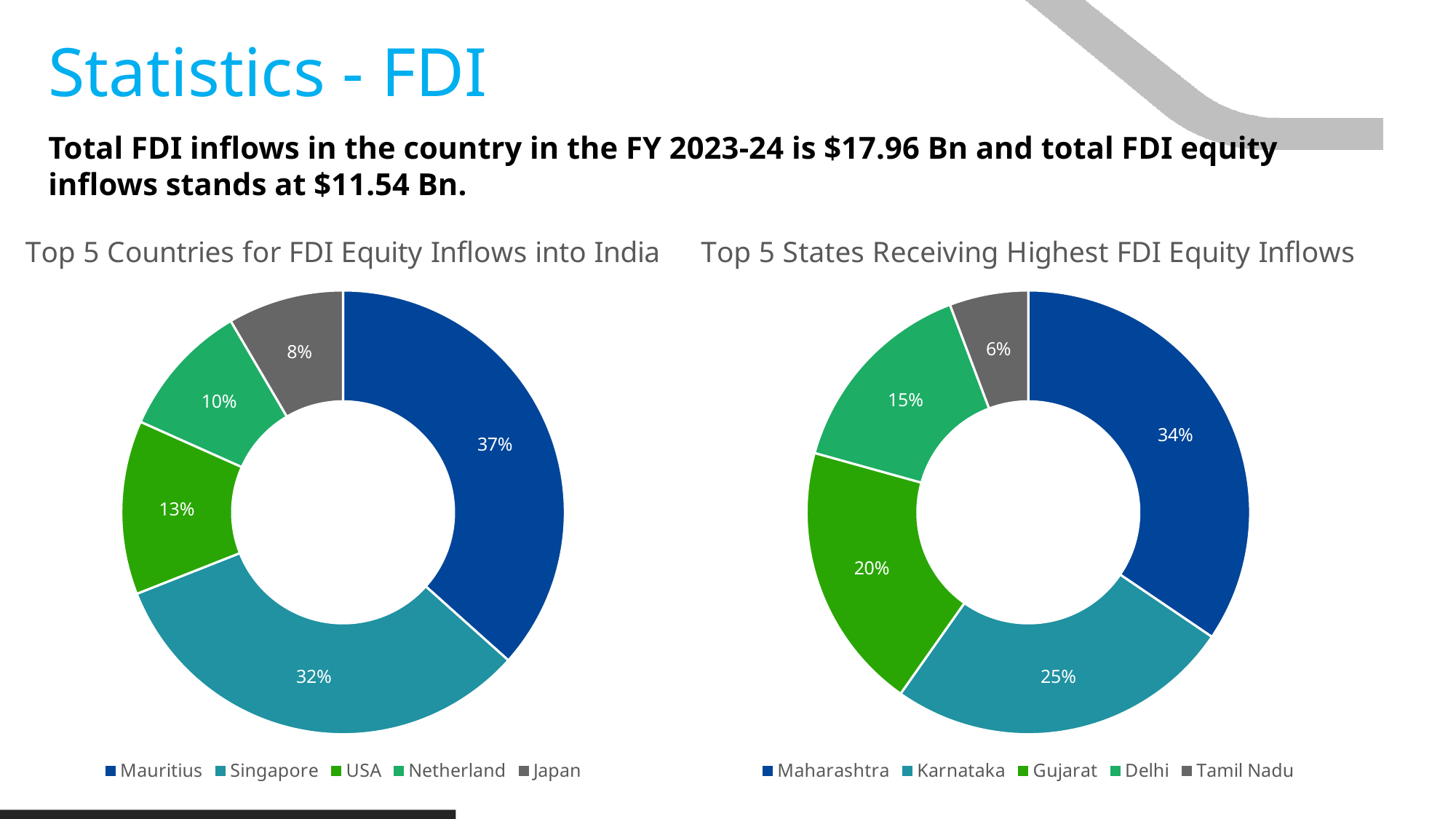
In the 'Top 5 Countries for FDI Equity Inflows into India' chart, what share does Singapore have? 32% In the 'Top 5 Countries for FDI Equity Inflows into India' chart, what share does Mauritius have? 37% In the 'Top 5 States Receiving Highest FDI Equity Inflows' chart, what share does Tamil Nadu have? 6% In the 'Top 5 States Receiving Highest FDI Equity Inflows' chart, what share does Gujarat have? 20% In the 'Top 5 Countries for FDI Equity Inflows into India' chart, which country has the smallest share? Japan In the 'Top 5 Countries for FDI Equity Inflows into India' chart, what is the difference between the shares of USA and Netherland? 3% In the 'Top 5 States Receiving Highest FDI Equity Inflows' chart, which is larger, the share of Karnataka or the share of Delhi? Karnataka In the 'Top 5 States Receiving Highest FDI Equity Inflows' chart, which state has the largest share? Maharashtra In the 'Top 5 Countries for FDI Equity Inflows into India' chart, which country is shown in grey? Japan In the 'Top 5 Countries for FDI Equity Inflows into India' chart, how many countries are shown? 5 In the 'Top 5 States Receiving Highest FDI Equity Inflows' chart, what is the difference between the shares of Maharashtra and Karnataka? 9% What type of chart is used for 'Top 5 States Receiving Highest FDI Equity Inflows'? Doughnut (pie) chart